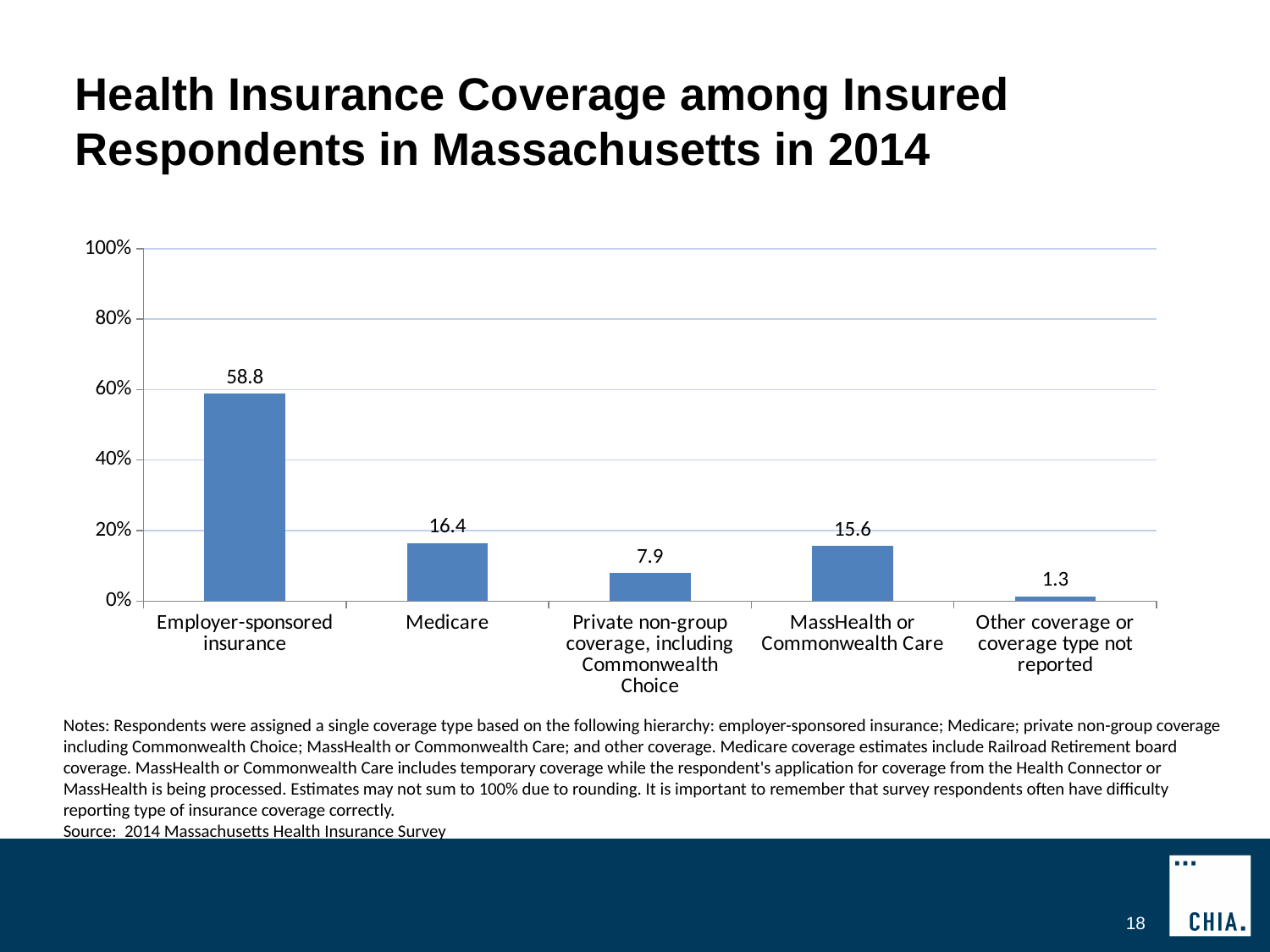
What is the difference between the values for Medicare and MassHealth or Commonwealth Care? 0.8 Which coverage type has the lowest value? Other coverage or coverage type not reported What is the value for Employer-sponsored insurance? 58.8 How many coverage categories are shown in the chart? 5 What is the value for MassHealth or Commonwealth Care? 15.6 Which is larger, the value for Medicare or the value for Private non-group coverage, including Commonwealth Choice? Medicare What is the value for Other coverage or coverage type not reported? 1.3 What is the value for Medicare? 16.4 Which coverage type has the highest value? Employer-sponsored insurance What is the title of the slide? Health Insurance Coverage among Insured Respondents in Massachusetts in 2014 What kind of chart is shown on the slide? Bar chart What is the value for Private non-group coverage, including Commonwealth Choice? 7.9